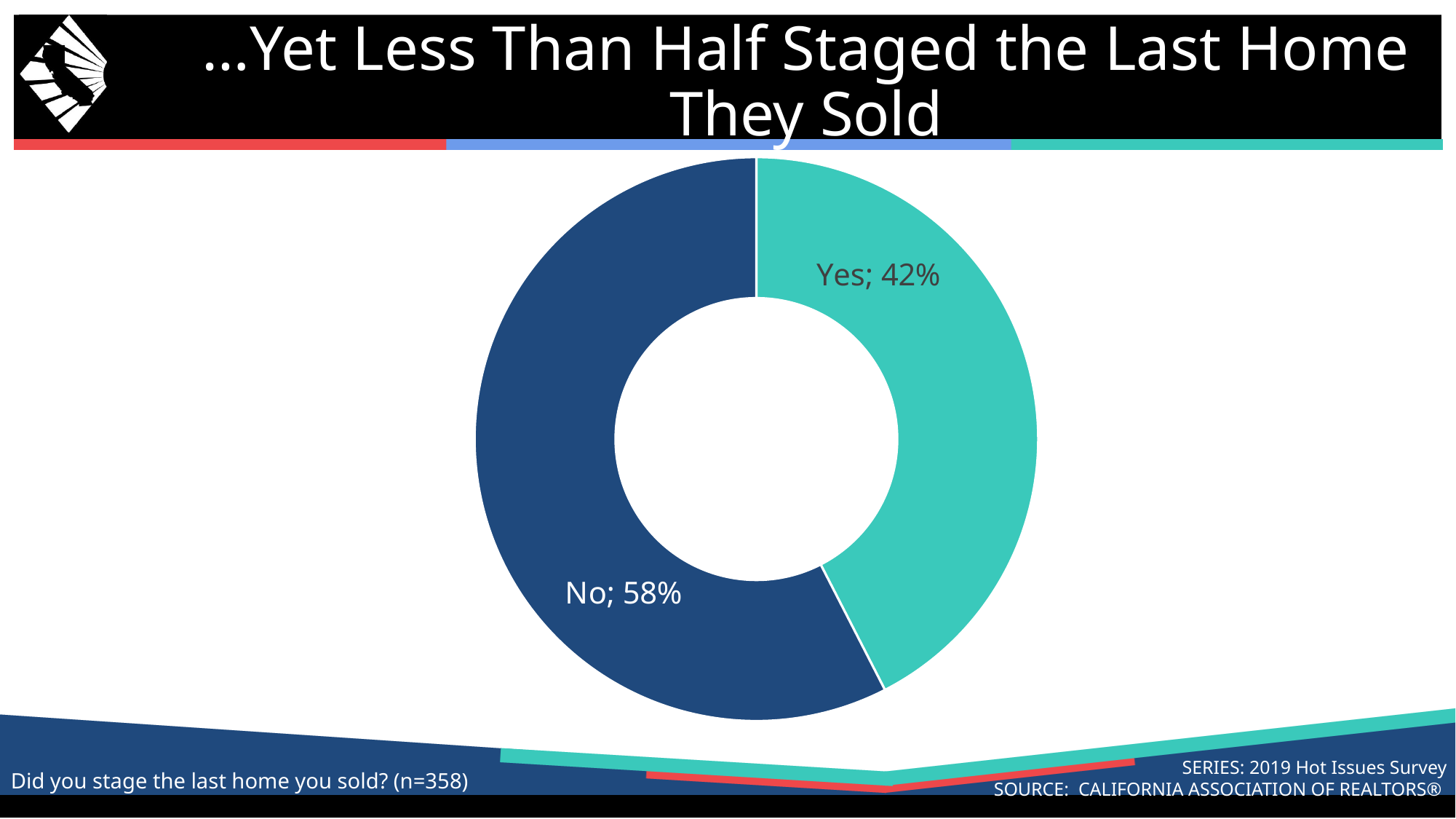
What is the difference in percentage points between the "No" and "Yes" shares? 16 How many categories are shown in the chart? 2 Is the share for "Yes" larger or smaller than the share for "No"? smaller What kind of chart is shown on the slide? doughnut (pie) chart What is the sample size (n) given for the survey question? 358 What is the title of the slide? …Yet Less Than Half Staged the Last Home They Sold Which response has the larger share of the chart? No What percentage of respondents answered "Yes"? 42% What percentage of respondents answered "No"? 58% What share of the chart does the "No" slice represent? 58% What colour is the "Yes" slice? teal Which response has the smaller share of the chart? Yes